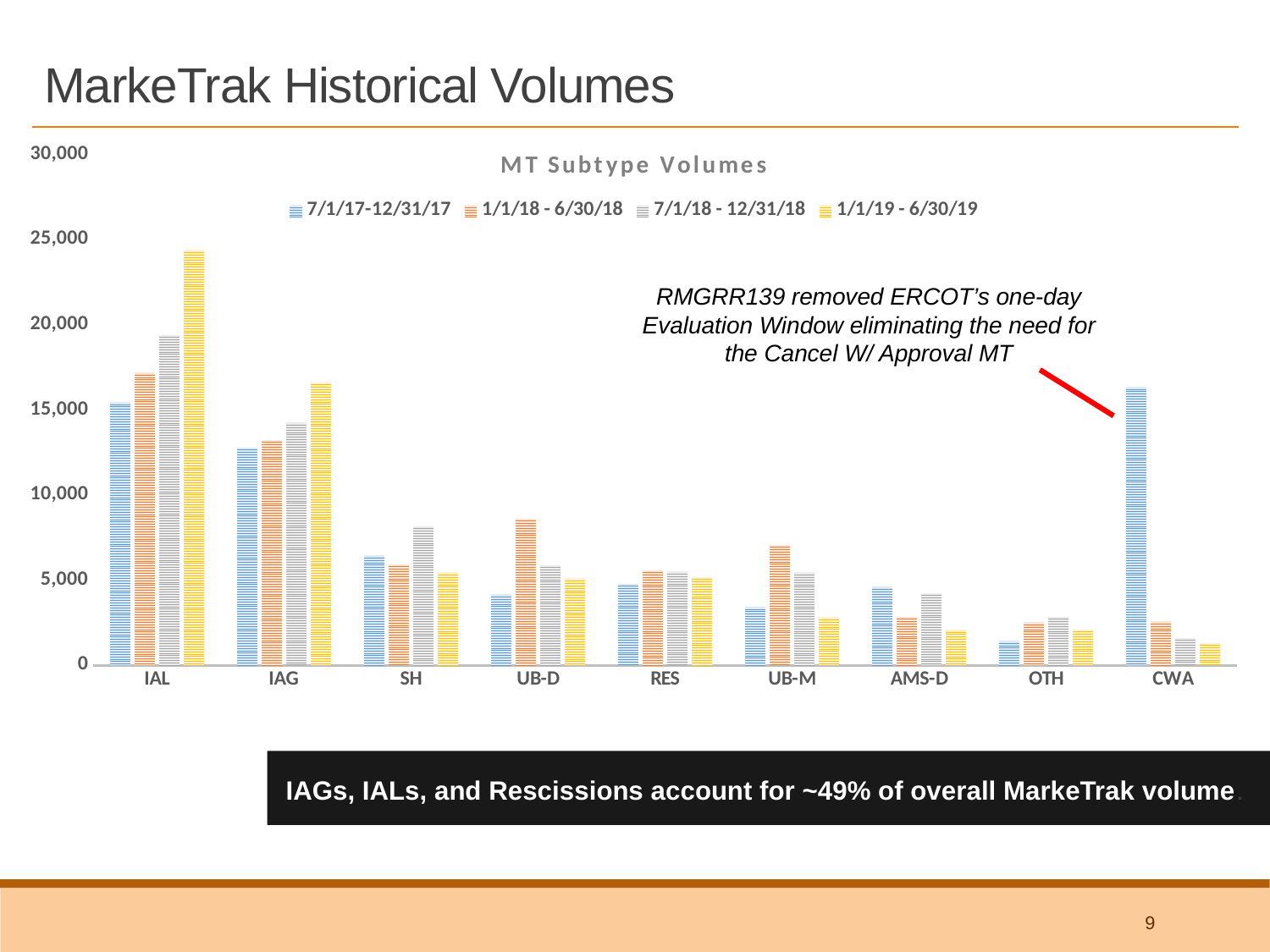
How many MT subtype categories are shown along the x axis? 9 Is the value for CWA in the 1/1/19 - 6/30/19 series greater or less than 5,000? less For UB-D, which series has the larger value: 7/1/17-12/31/17 or 1/1/18 - 6/30/18? 1/1/18 - 6/30/18 Which category has the lowest value for the 7/1/17-12/31/17 series? OTH How many series does the legend list? 4 For the 7/1/18 - 12/31/18 series, which is larger: IAL or IAG? IAL Which category has the highest value for the 1/1/19 - 6/30/19 series? IAL Is the value for IAL in the 1/1/19 - 6/30/19 series greater or less than 20,000? greater Do the IAL values rise or fall across the four periods from 7/1/17-12/31/17 to 1/1/19 - 6/30/19? rise Is the value for CWA in the 7/1/17-12/31/17 series greater or less than 15,000? greater What is the title of the chart? MT Subtype Volumes What type of chart is shown on the slide? bar chart